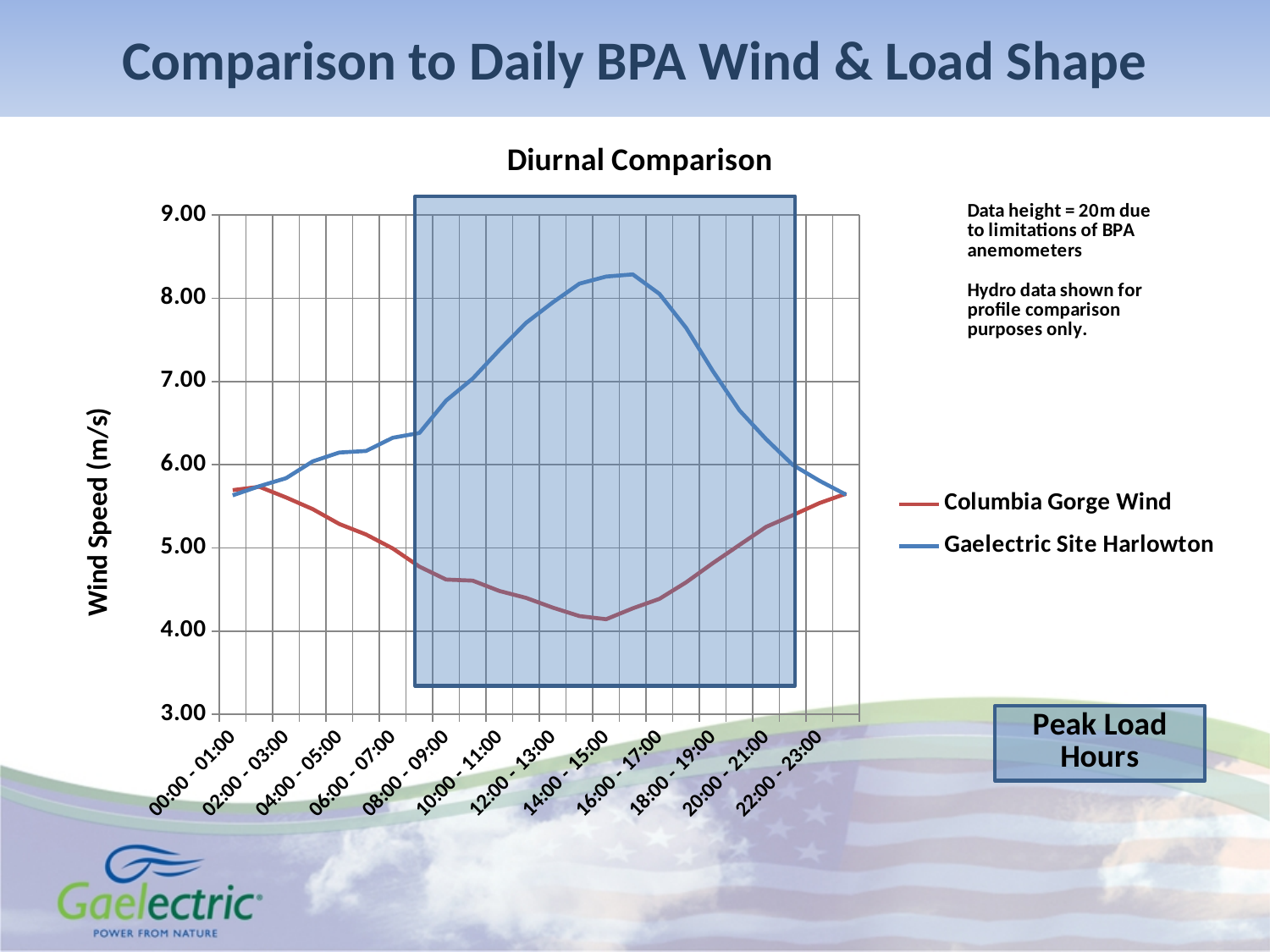
What is the label of the vertical axis of the Diurnal Comparison chart? Wind Speed (m/s) What is the title of the chart on the slide? Diurnal Comparison Does the Columbia Gorge Wind series rise or fall from 00:00 - 01:00 to 14:00 - 15:00? fall Does the Gaelectric Site Harlowton series rise or fall from 00:00 - 01:00 to 14:00 - 15:00? rise Is the Columbia Gorge Wind value at 08:00 - 09:00 greater or less than 5.00? less Is the Gaelectric Site Harlowton value at 08:00 - 09:00 greater or less than 6.00? greater Is the Gaelectric Site Harlowton value at 14:00 - 15:00 greater or less than 8.00? greater At 14:00 - 15:00, which series has the higher wind speed, Columbia Gorge Wind or Gaelectric Site Harlowton? Gaelectric Site Harlowton What kind of chart is the Diurnal Comparison chart? line chart How many series does the legend of the Diurnal Comparison chart list? 2